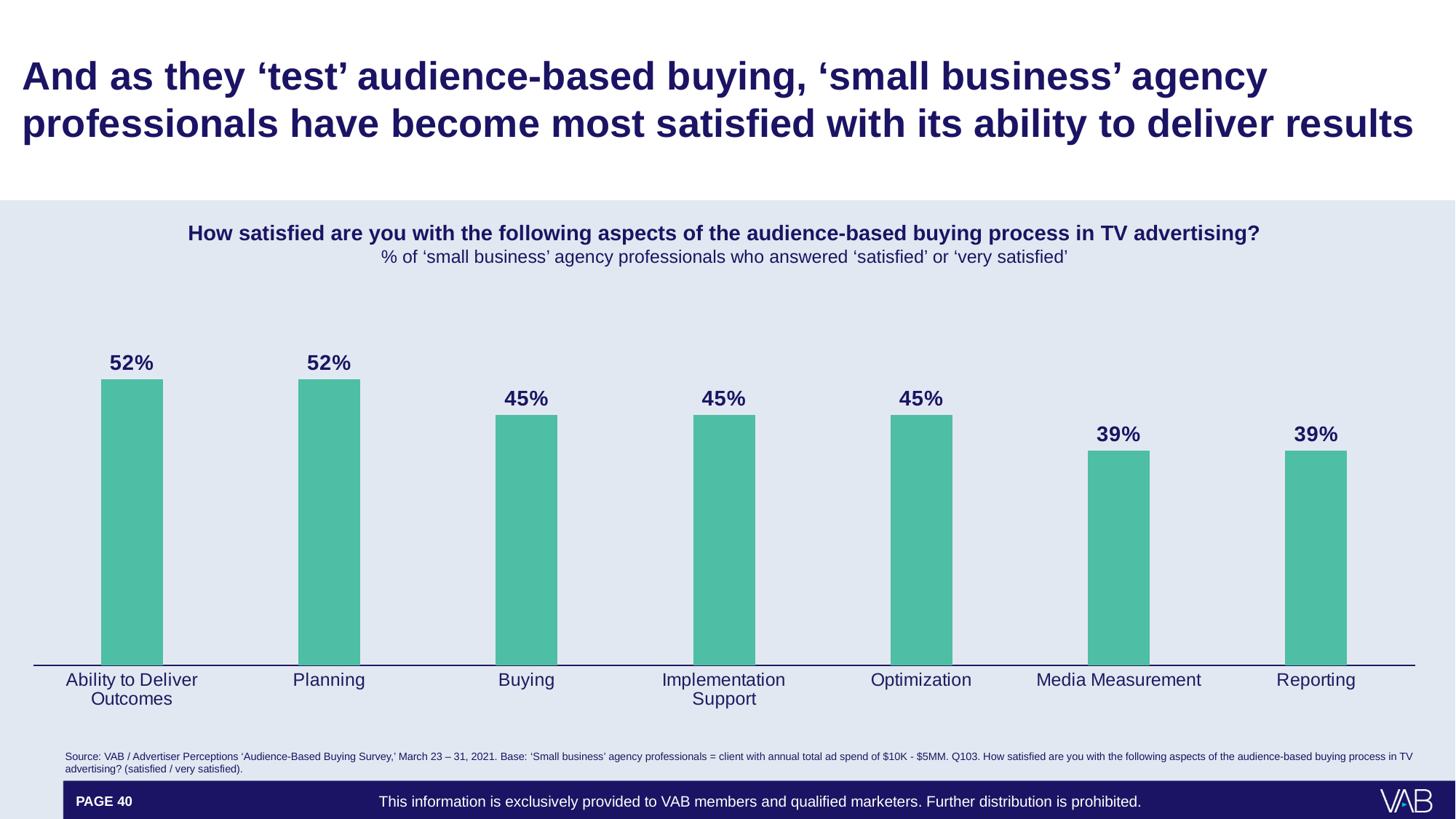
What percentage of 'small business' agency professionals are satisfied with Planning? 52% What is the difference between the values for Planning and Buying? 7% Which categories share the highest value on the chart? Ability to Deliver Outcomes and Planning Which is larger, the value for Buying or the value for Media Measurement? Buying What is the value shown for Media Measurement? 39% What is the value shown for Implementation Support? 45% What is the value shown for Reporting? 39% How many categories are shown on the chart? 7 What is the difference between the values for Optimization and Reporting? 6% Do the values rise or fall moving from left to right across the categories? Fall What kind of chart is shown on the slide? Bar chart Which categories share the lowest value on the chart? Media Measurement and Reporting